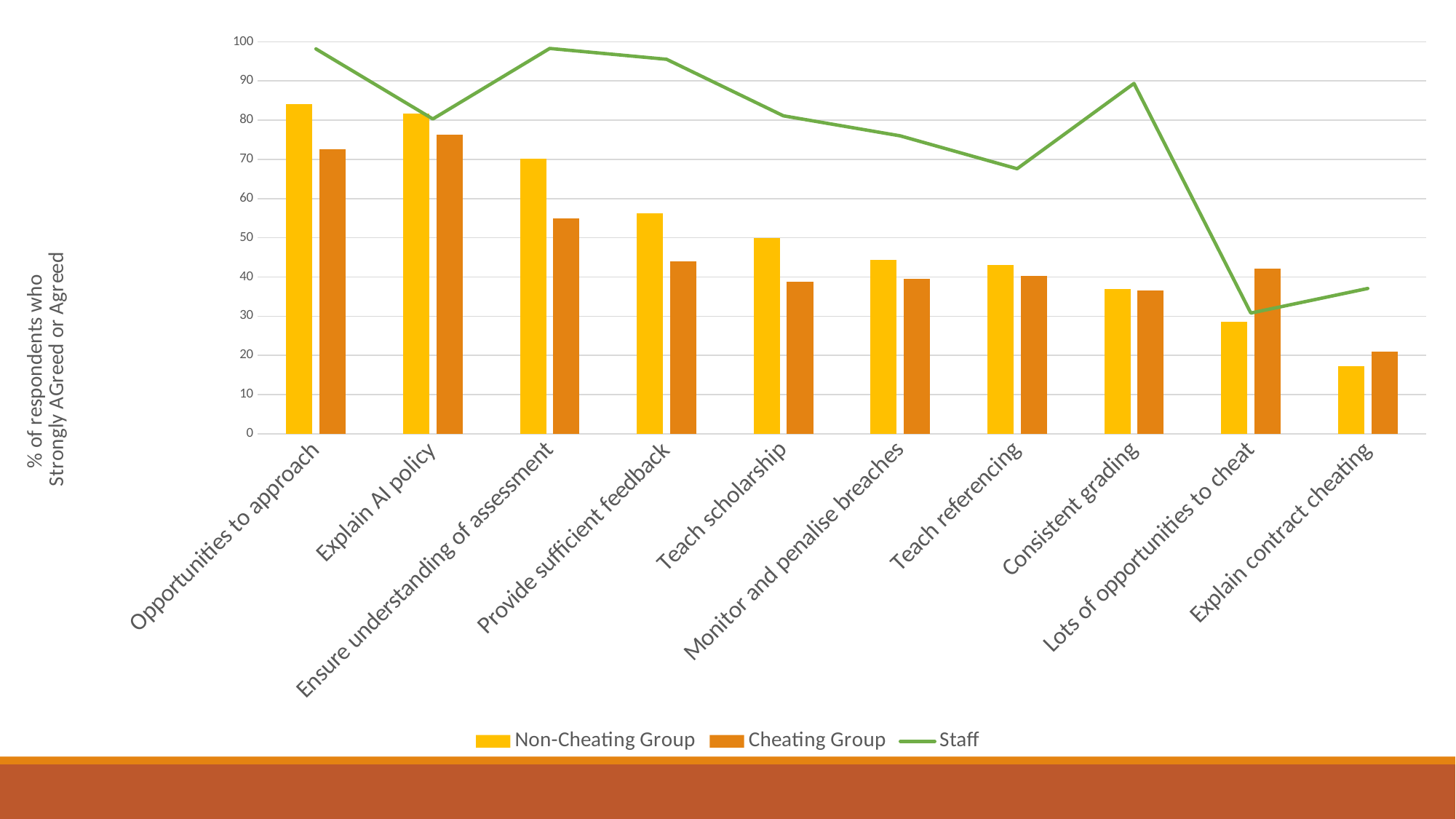
Which category has the lowest value for Staff? Lots of opportunities to cheat Is the Cheating Group value for Explain contract cheating greater or less than 30? less How many series does the legend list? 3 Is the Non-Cheating Group value for Opportunities to approach greater or less than 80? greater What kind of chart is this? Bar chart with a line series Which category has the highest value for the Cheating Group? Explain AI policy Which category has the highest value for the Non-Cheating Group? Opportunities to approach Is the Staff value for Consistent grading greater or less than 80? greater How many categories are shown on the x axis? 10 Do the Non-Cheating Group values rise or fall from left to right along the x axis? fall Which category has the lowest value for the Non-Cheating Group? Explain contract cheating For Lots of opportunities to cheat, which is larger: the Non-Cheating Group or the Cheating Group? Cheating Group